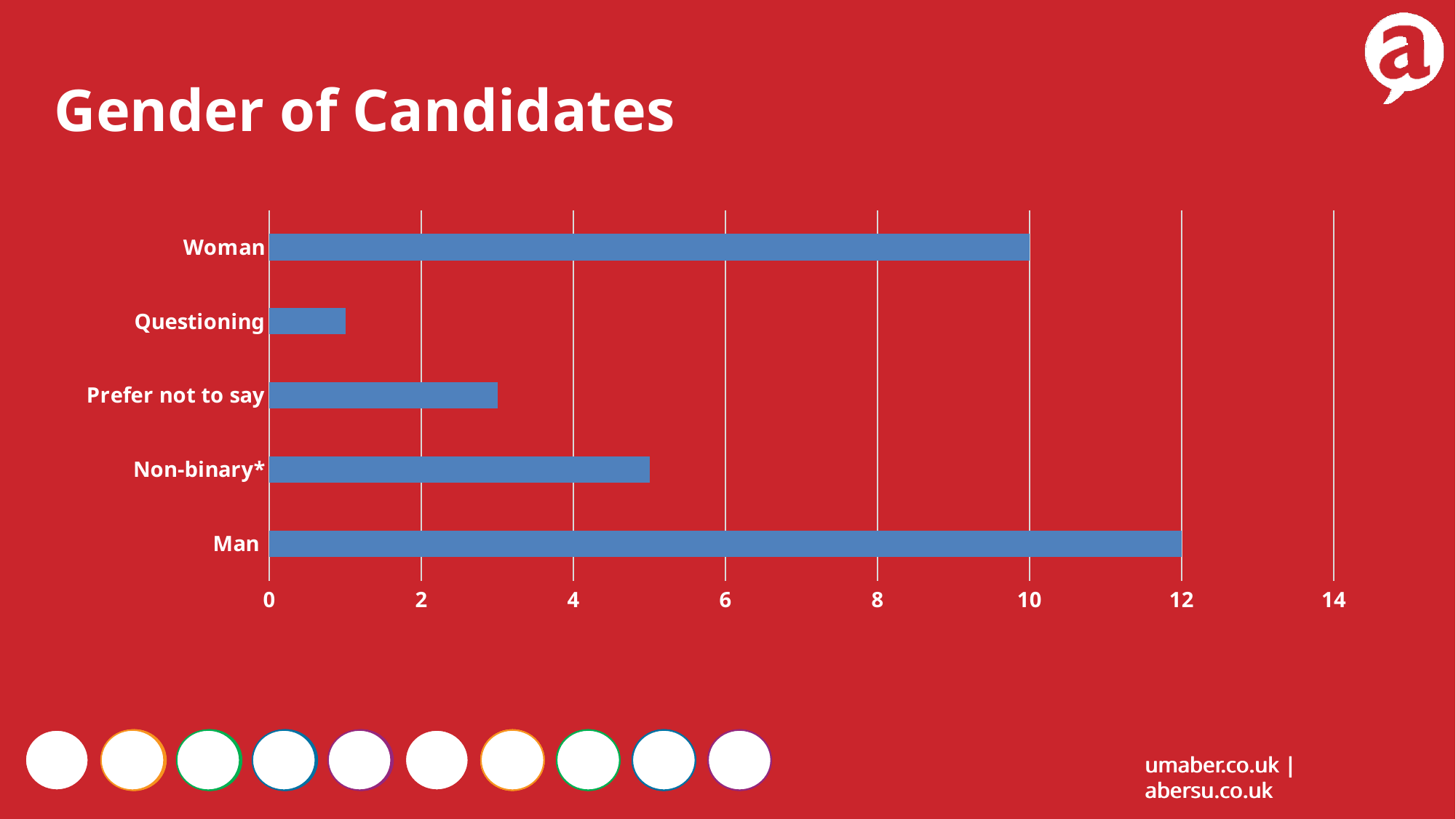
What is the difference between the values for Man and Woman? 2 Is the value for Non-binary* greater or less than 4? greater What is the value for Man? 12 Which category has the highest value? Man Which category has the lowest value? Questioning Is the value for Questioning greater or less than 2? less What is the value for Woman? 10 What is the title of the chart? Gender of Candidates Which is larger, the value for Non-binary* or the value for Prefer not to say? Non-binary* What type of chart is shown on the slide? bar chart Is the value for Prefer not to say greater or less than 4? less How many categories are shown in the chart? 5